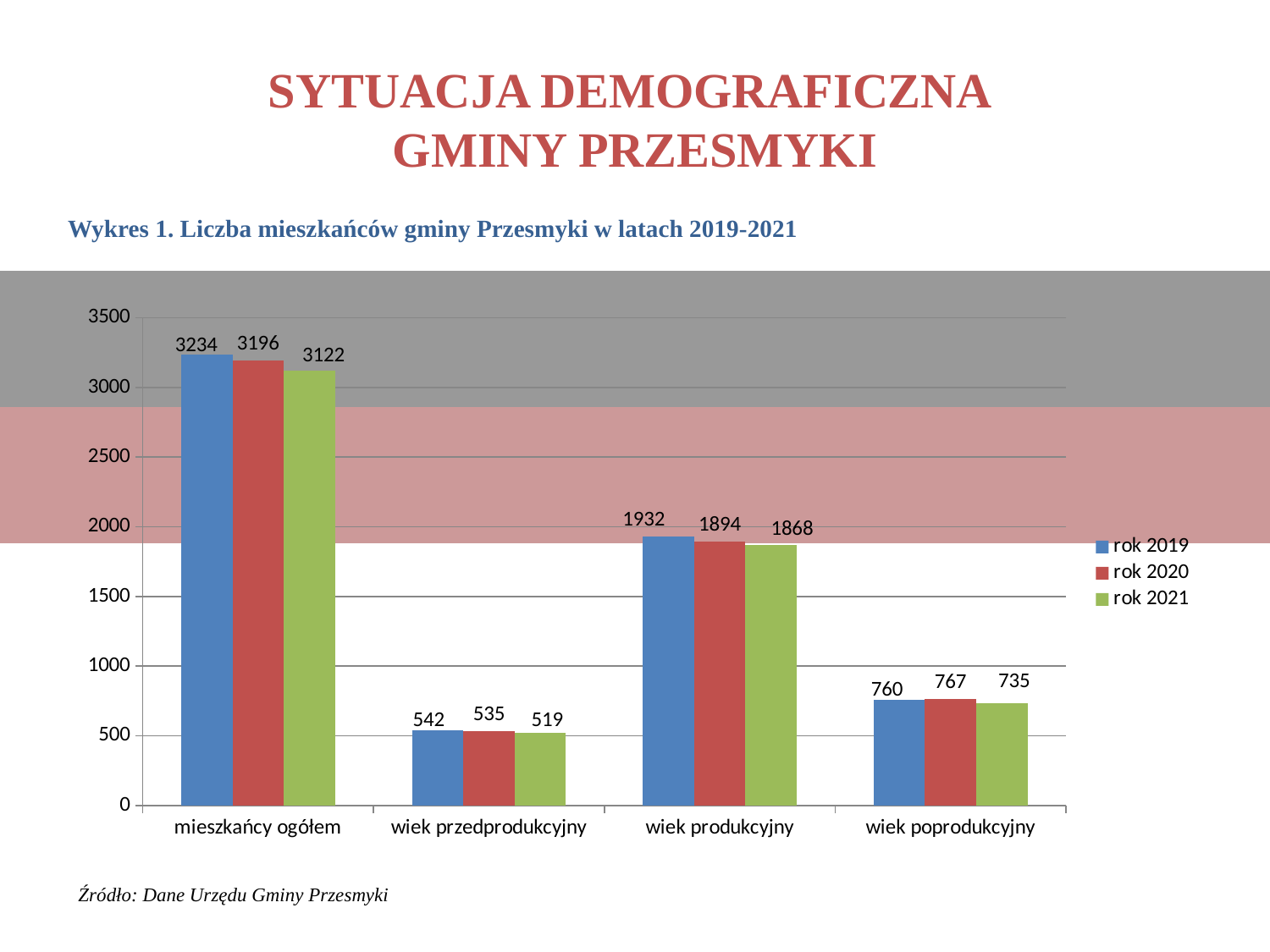
Do the values for 'wiek przedprodukcyjny' rise or fall from 'rok 2019' to 'rok 2021'? fall What is the value for 'mieszkańcy ogółem' in the 'rok 2019' series? 3234 What is the value for 'wiek poprodukcyjny' in the 'rok 2020' series? 767 What is the value for 'wiek produkcyjny' in the 'rok 2021' series? 1868 Which category has the lowest value in the 'rok 2021' series? wiek przedprodukcyjny What kind of chart is shown on the slide? bar chart Which is larger for 'wiek poprodukcyjny': the 'rok 2019' value or the 'rok 2021' value? rok 2019 Is the 'rok 2019' value for 'wiek produkcyjny' greater or less than 1500? greater How many categories are shown on the x axis? 4 Which category has the highest value in the 'rok 2020' series? mieszkańcy ogółem What is the difference between the 'rok 2019' and 'rok 2021' values for 'mieszkańcy ogółem'? 112 How many series does the legend list? 3